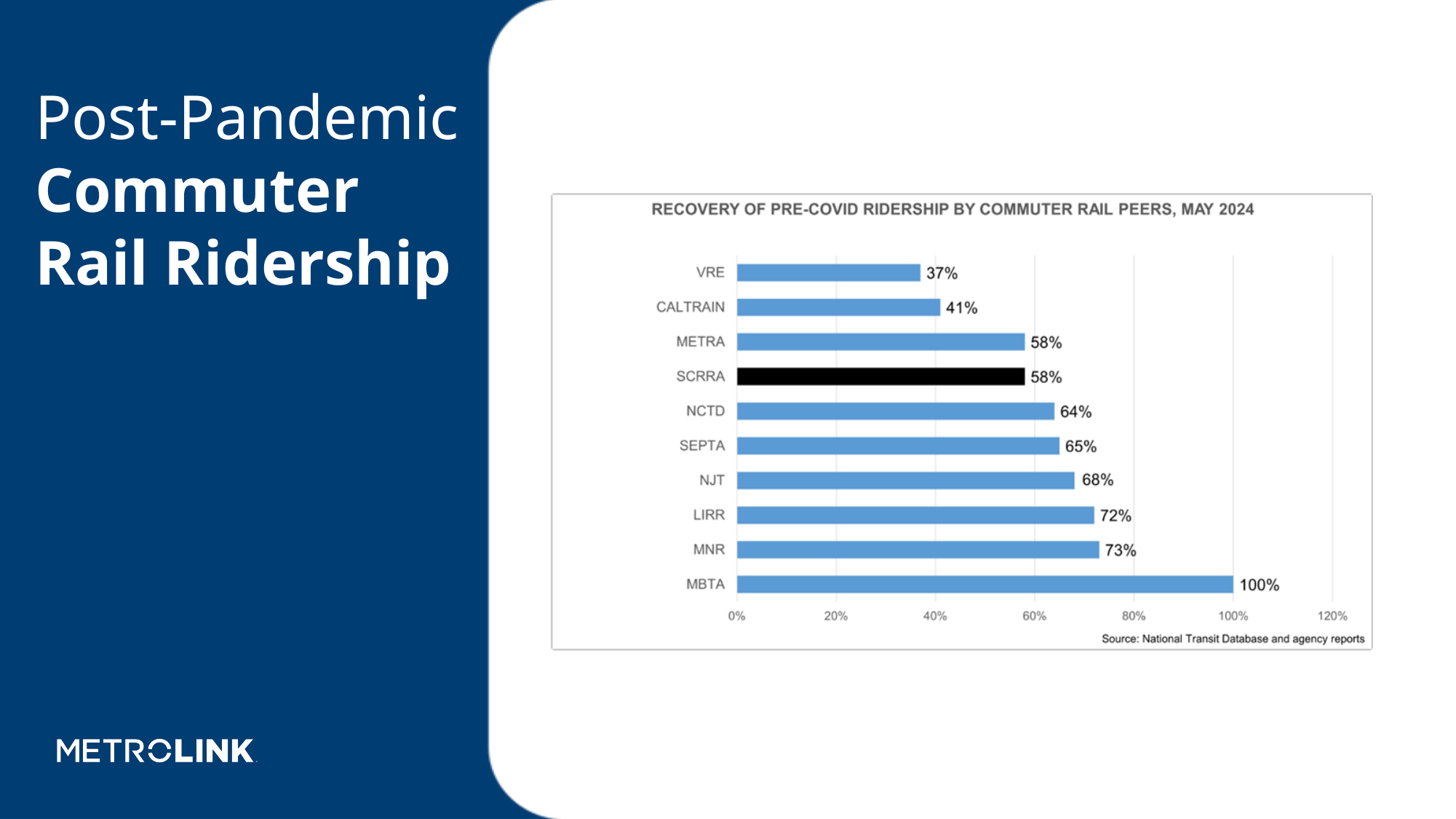
What kind of chart is shown on the slide? Bar chart What is the difference between the recovery values for LIRR and NCTD? 8% What is the recovery of pre-COVID ridership for MNR? 73% What is the recovery of pre-COVID ridership for SCRRA? 58% Which commuter rail agency has the highest recovery of pre-COVID ridership? MBTA What is the difference between the recovery values for MBTA and CALTRAIN? 59% Which has a higher recovery of pre-COVID ridership, NJT or SEPTA? NJT Is the value for METRA greater or less than 60%? less Which agency's bar is shown in black rather than blue? SCRRA How many commuter rail agencies are shown in the chart? 10 Which commuter rail agency has the lowest recovery of pre-COVID ridership? VRE What is the recovery of pre-COVID ridership for VRE? 37%